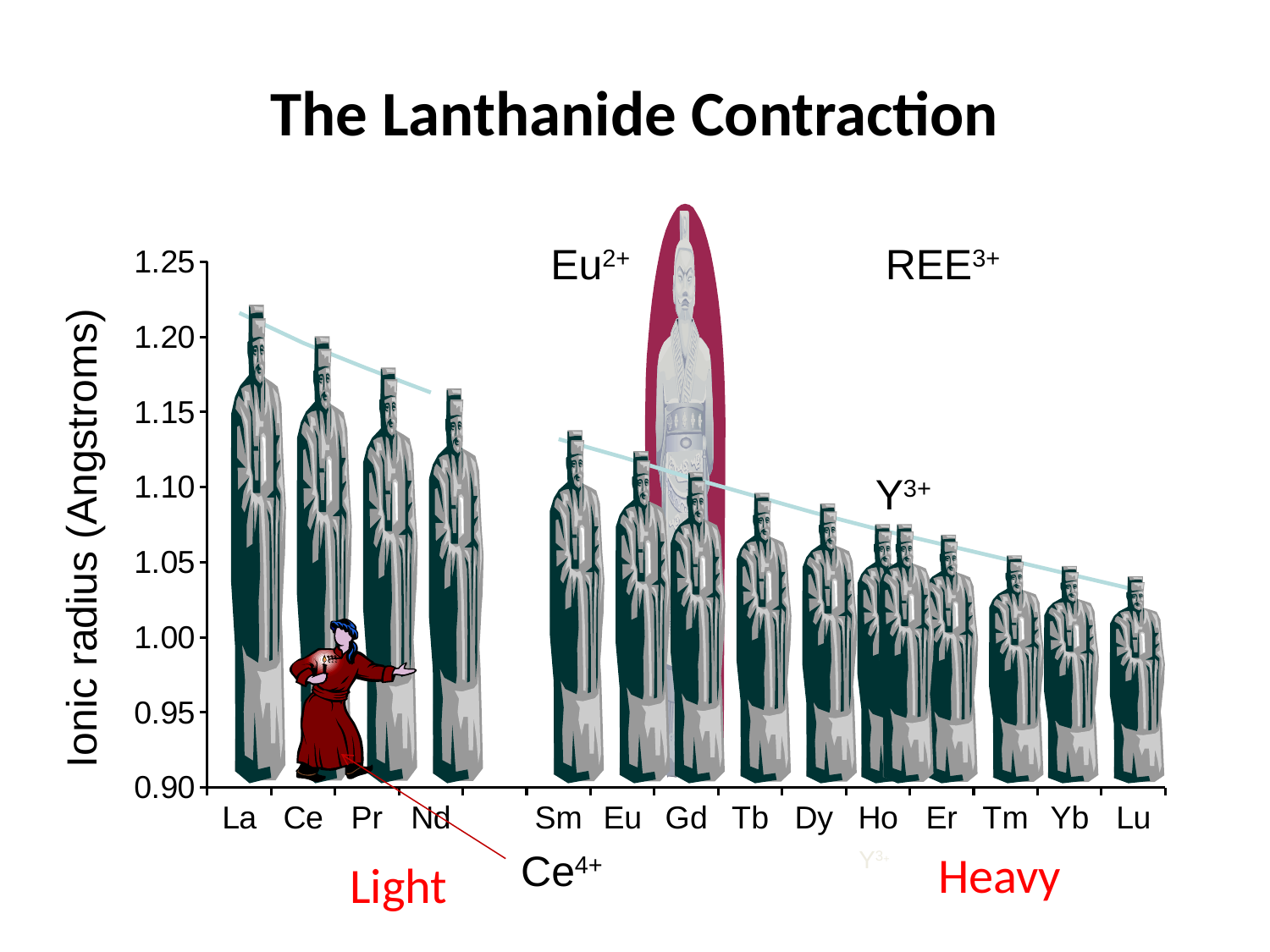
How many elements are labelled along the x axis? 14 What kind of chart is shown on the slide? line chart Which has the larger ionic radius, La or Lu? La Which element has the smallest ionic radius on the chart? Lu Is the ionic radius for Lu greater or less than 1.05? less Which has the larger ionic radius, Nd or Sm? Nd Is the ionic radius for La greater or less than 1.20? greater Is the ionic radius for Sm greater or less than 1.15? less What is the label of the vertical axis? Ionic radius (Angstroms) What is the title of the chart on the slide? The Lanthanide Contraction Do the ionic radii rise or fall from La to Lu along the x axis? fall Which element has the largest ionic radius on the chart? La